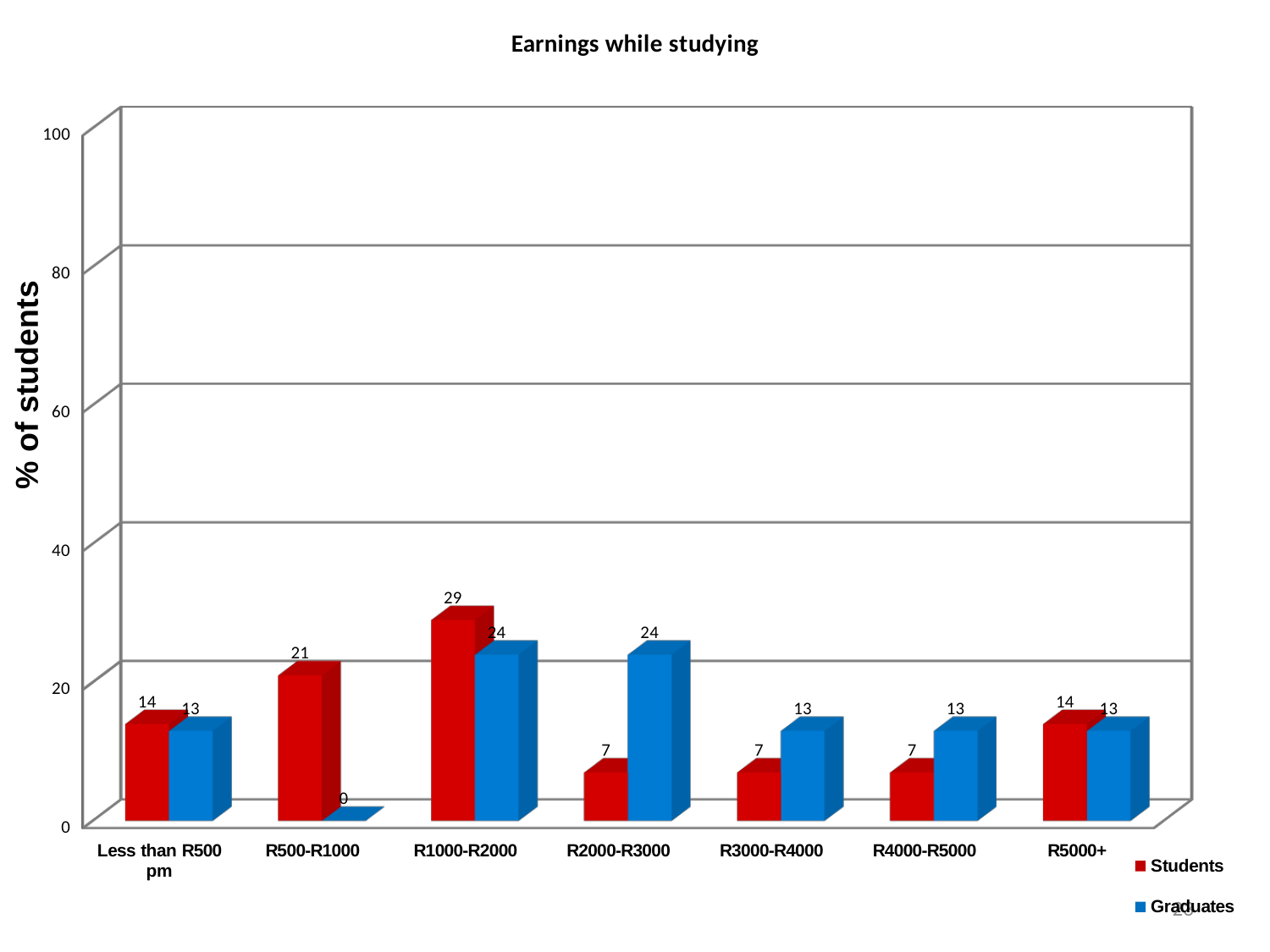
Which category has the lowest value for Graduates? R500-R1000 How many earnings categories are shown on the x axis? 7 What is the difference between the Students and Graduates values in the R2000-R3000 category? 17 What is the title of the chart? Earnings while studying Is the value for Students in the R1000-R2000 category greater or less than 20? greater What is the value for Graduates in the R500-R1000 category? 0 What is the value for Students in the R1000-R2000 category? 29 How many series does the legend list? 2 Which category has the highest value for Students? R1000-R2000 What kind of chart is shown? Bar chart Which is larger in the R500-R1000 category, Students or Graduates? Students What is the value for Graduates in the R2000-R3000 category? 24